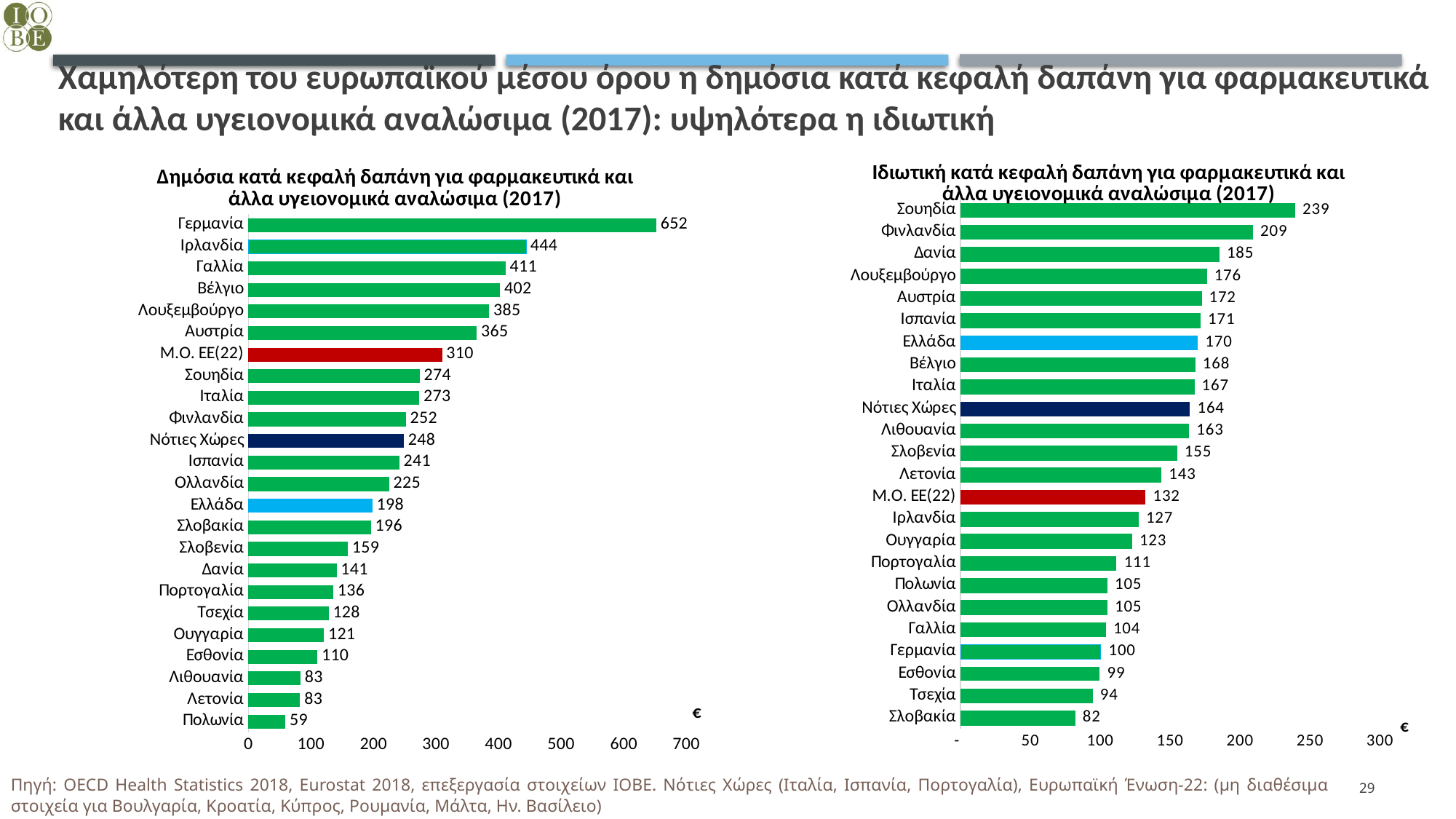
In the right chart (Ιδιωτική κατά κεφαλή δαπάνη), which is larger: Ελλάδα or Γερμανία? Ελλάδα In the right chart (Ιδιωτική κατά κεφαλή δαπάνη), what is the value for Μ.Ο. ΕΕ(22)? 132 What type of chart is the left chart (Δημόσια κατά κεφαλή δαπάνη)? Bar chart In the right chart (Ιδιωτική κατά κεφαλή δαπάνη), what is the value for Νότιες Χώρες? 164 In the left chart (Δημόσια κατά κεφαλή δαπάνη), how many bars are plotted? 24 In the left chart (Δημόσια κατά κεφαλή δαπάνη), what is the value for Ελλάδα? 198 In the left chart (Δημόσια κατά κεφαλή δαπάνη), what colour is the bar for Μ.Ο. ΕΕ(22)? Red In the right chart (Ιδιωτική κατά κεφαλή δαπάνη), what is the difference between Σουηδία and Σλοβακία? 157 In the left chart (Δημόσια κατά κεφαλή δαπάνη), which category has the lowest value? Πολωνία In the left chart (Δημόσια κατά κεφαλή δαπάνη), what is the value for Γερμανία? 652 In the right chart (Ιδιωτική κατά κεφαλή δαπάνη), which category has the highest value? Σουηδία In the left chart (Δημόσια κατά κεφαλή δαπάνη), what is the difference between Μ.Ο. ΕΕ(22) and Ελλάδα? 112